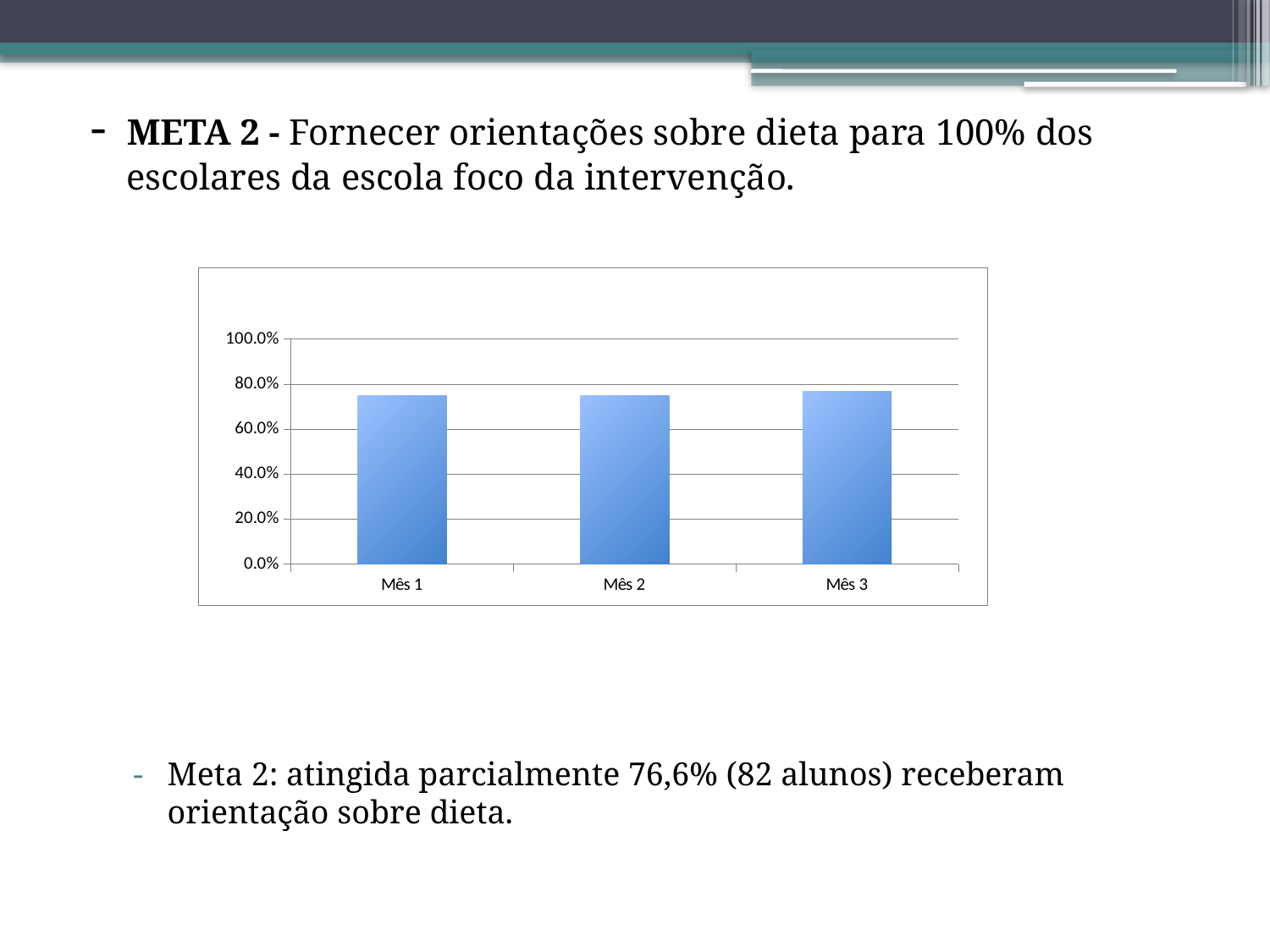
Is the value for Mês 2 greater or less than 40.0%? greater Is the value for Mês 2 greater or less than 80.0%? less Is the value for Mês 1 greater or less than 80.0%? less What kind of chart is shown on the slide? bar chart How many categories (months) are plotted on the chart? 3 What is the highest value shown on the vertical axis of the chart? 100.0% What is the label of the first category on the x axis? Mês 1